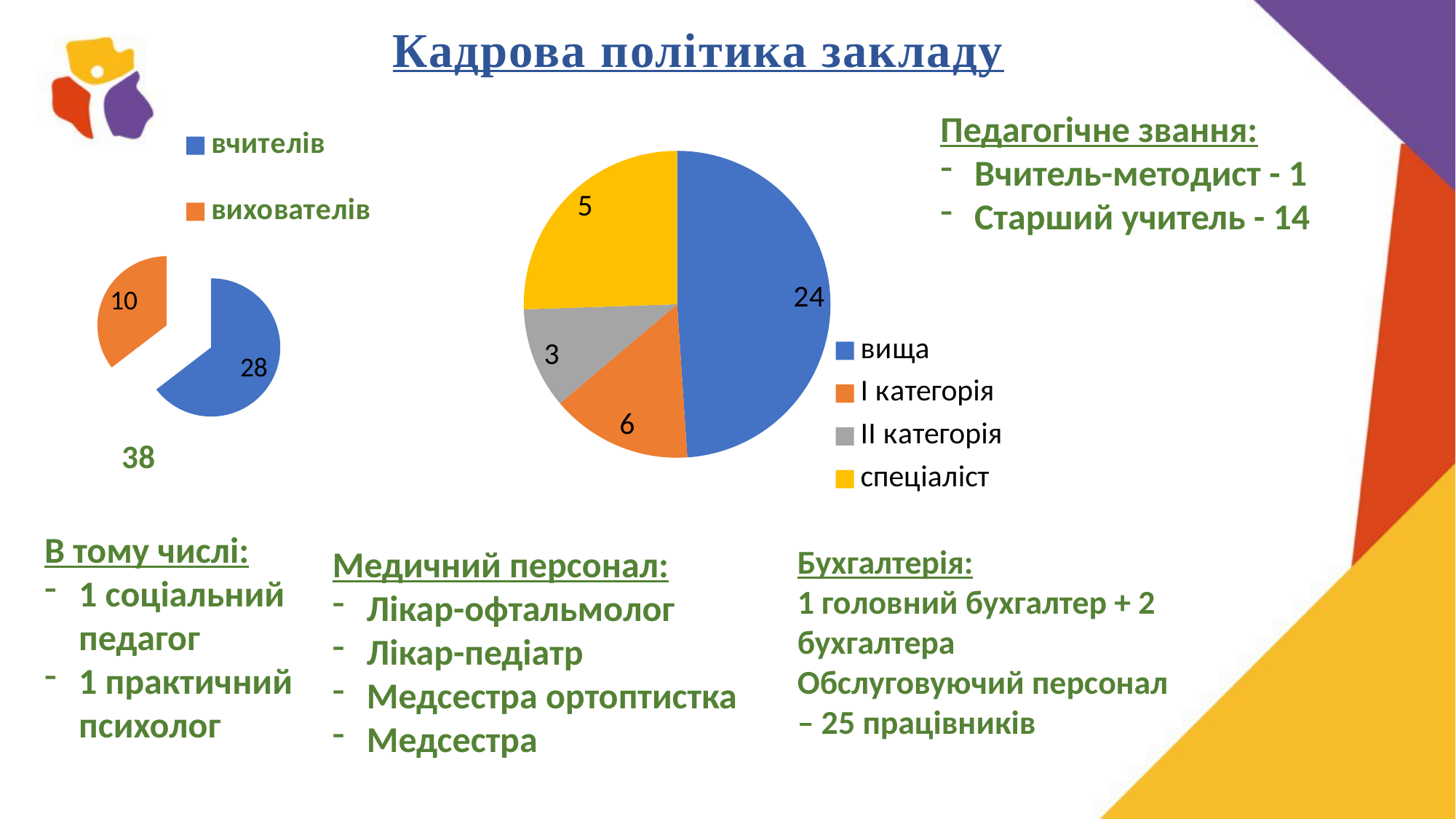
In the right pie chart, which category has the smallest slice? II категорія In the left pie chart, what is the value for вчителів? 28 In the right pie chart, which category has the largest slice? вища In the left pie chart, what is the total of the two slices? 38 What type of chart is the right chart? pie chart In the right pie chart, what is the value for вища? 24 In the left pie chart, how many slices are there? 2 In the left pie chart, what is the value for вихователів? 10 In the right pie chart, what is the value for II категорія? 3 In the right pie chart, how many categories does the legend list? 4 In the right pie chart, what is the difference between the values for вища and спеціаліст? 19